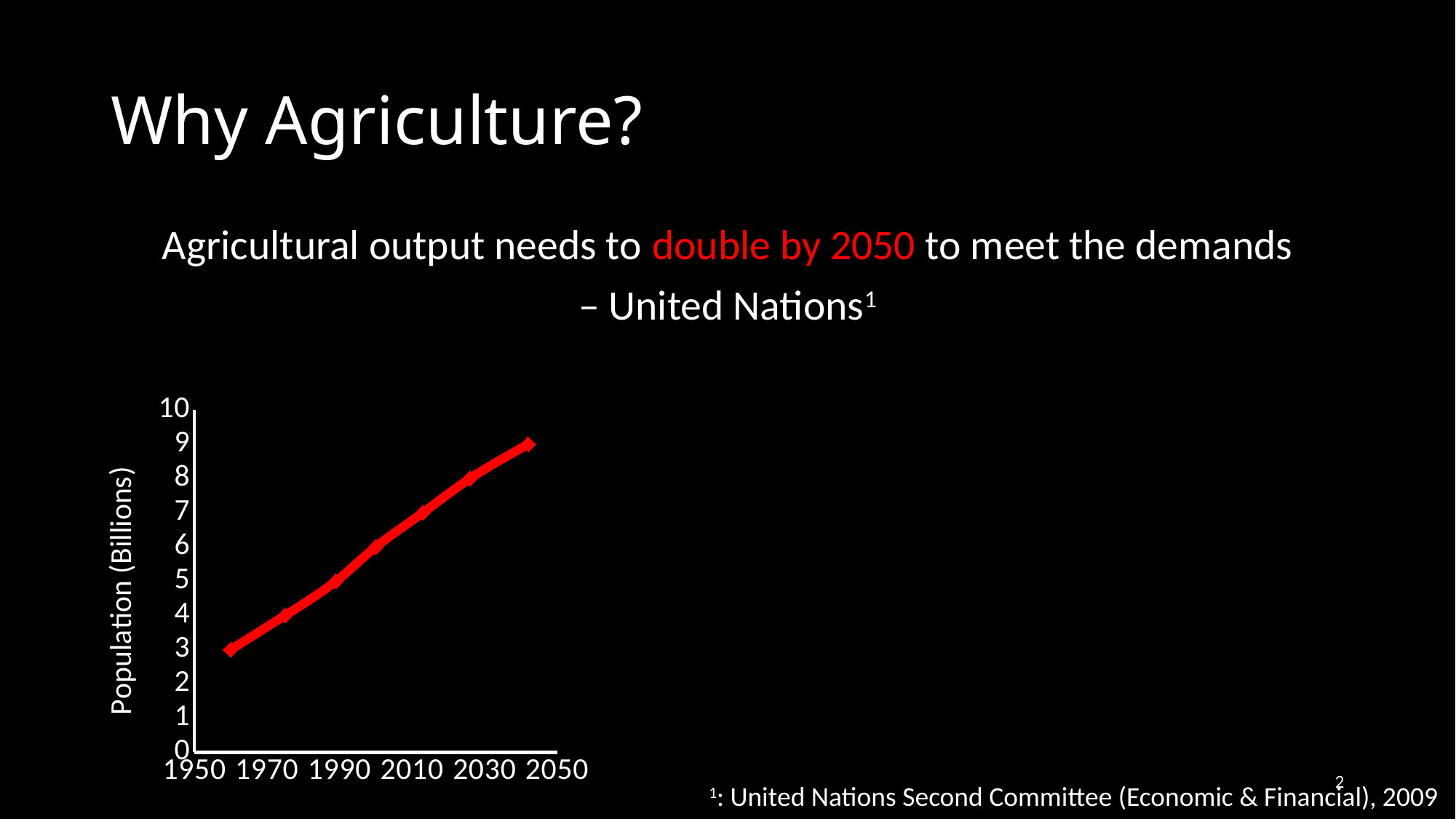
What is the highest population value reached by the line? 9 Which is larger, the value of the leftmost point or the value of the rightmost point? the rightmost point What is the value of the rightmost (latest) point on the line? 9 How many data points are marked on the line? 7 What is the maximum value shown on the vertical axis? 10 What kind of chart is shown on the slide? line chart What is the lowest population value on the line? 3 What is the value of the leftmost (earliest) point on the line? 3 Is the value of the rightmost point on the line greater or less than 5? greater What is the difference between the highest and lowest values on the line? 6 Does the plotted population line rise or fall from left to right along the x axis? rise What is the label of the vertical axis of the chart? Population (Billions)